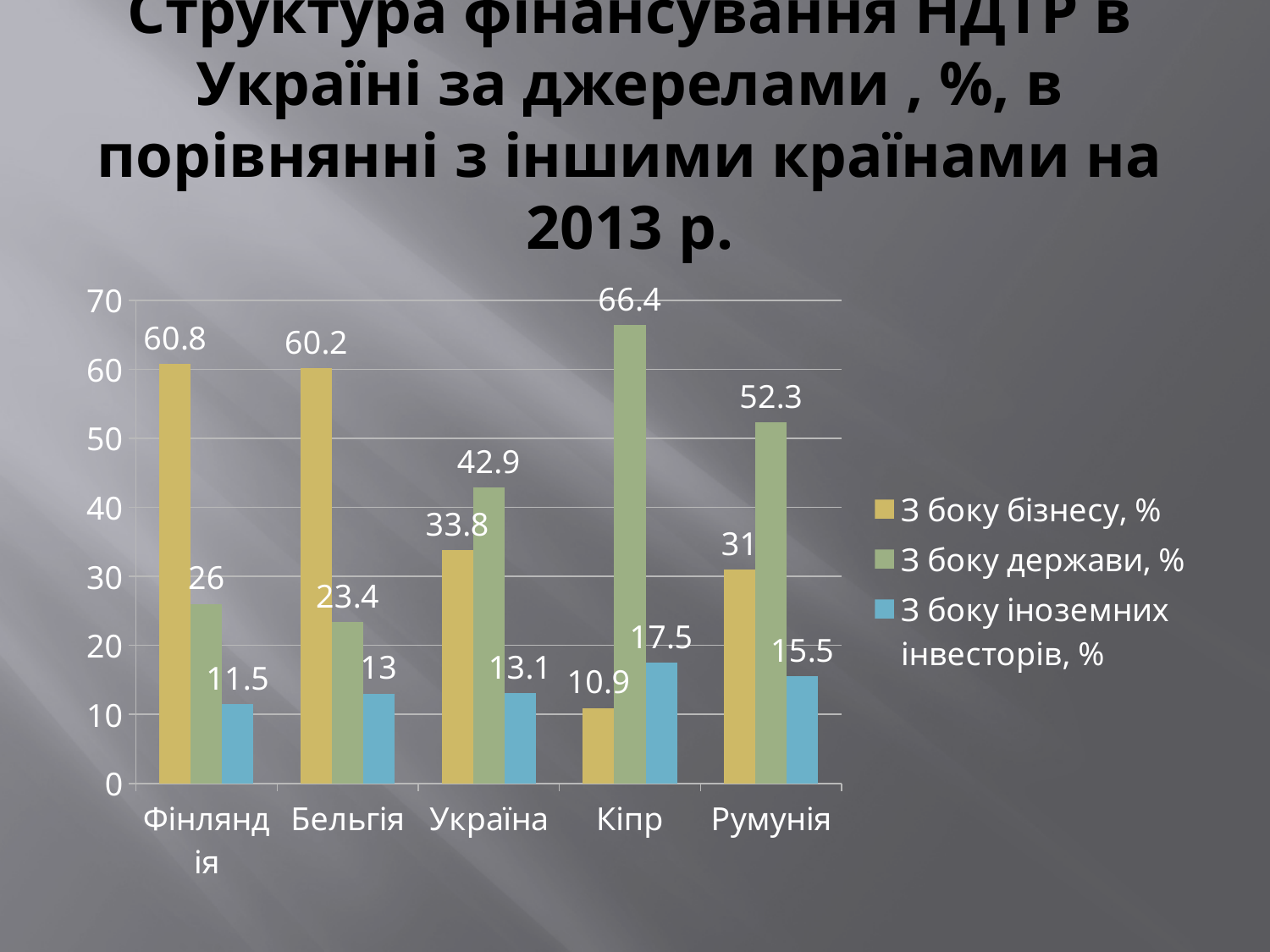
Is the value for Бельгія in the series "З боку держави, %" greater or less than 30? less Which country has the highest value in the series "З боку держави, %"? Кіпр Which country has the lowest value in the series "З боку іноземних інвесторів, %"? Фінляндія What kind of chart is shown on the slide? bar chart Which is larger for Україна: the value for "З боку бізнесу, %" or "З боку держави, %"? З боку держави, % How many countries are shown on the x axis of the chart? 5 How many series does the legend list? 3 Which colour represents the series "З боку іноземних інвесторів, %" in the chart? blue What is the value for Румунія in the series "З боку іноземних інвесторів, %"? 15.5 What is the difference between the "З боку бізнесу, %" values for Фінляндія and Україна? 27 What is the value for Кіпр in the series "З боку бізнесу, %"? 10.9 What is the value for Україна in the series "З боку держави, %"? 42.9